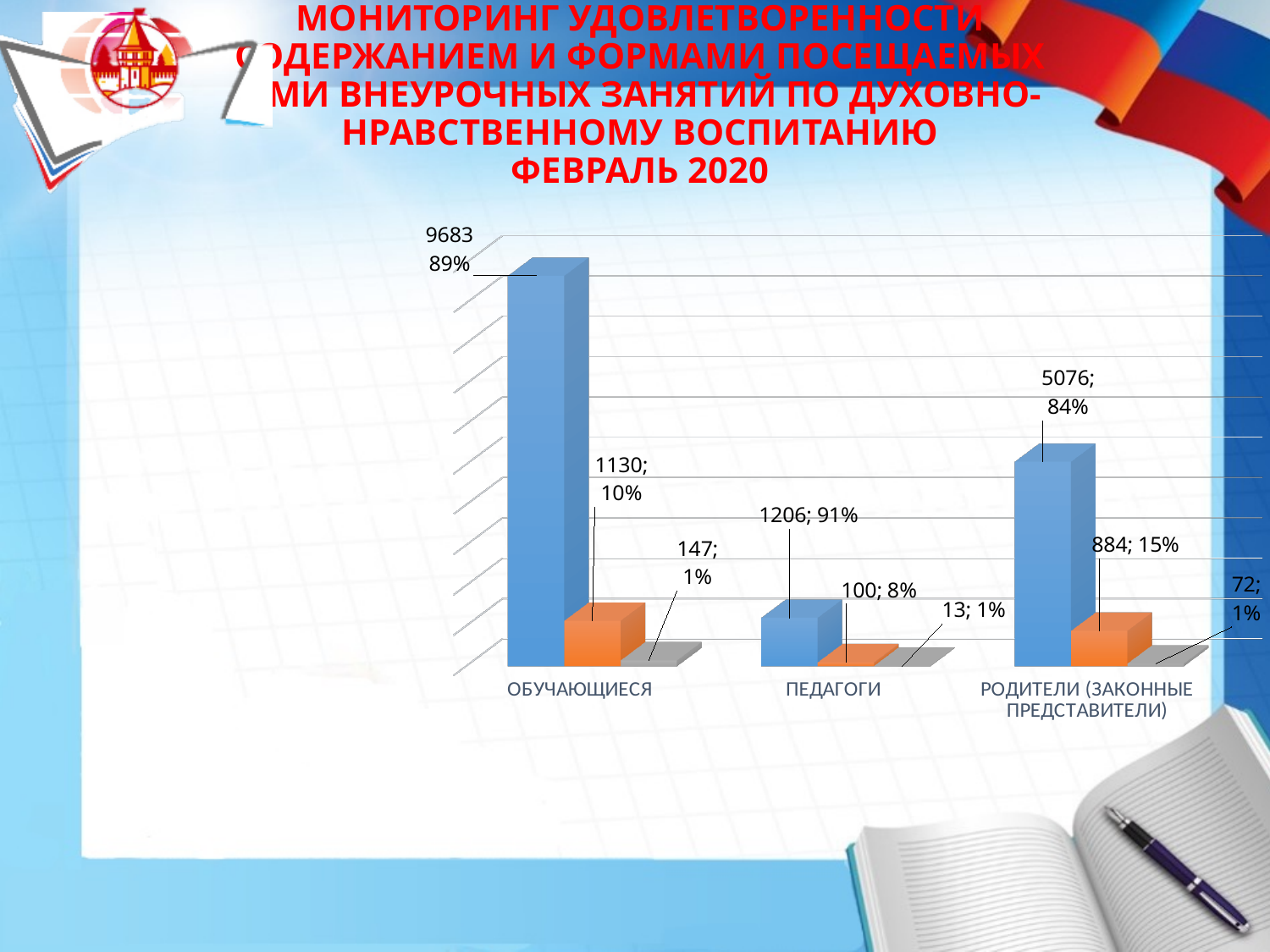
What is the value of the gray bar for РОДИТЕЛИ (ЗАКОННЫЕ ПРЕДСТАВИТЕЛИ)? 72; 1% What month and year are given in the chart title? ФЕВРАЛЬ 2020 Which category has the highest blue bar? ОБУЧАЮЩИЕСЯ What is the difference between the blue bar values for ОБУЧАЮЩИЕСЯ and РОДИТЕЛИ (ЗАКОННЫЕ ПРЕДСТАВИТЕЛИ)? 4607 How many categories are shown on the x axis of the chart? 3 What is the value of the orange bar for ПЕДАГОГИ? 100; 8% What is the value of the blue bar for РОДИТЕЛИ (ЗАКОННЫЕ ПРЕДСТАВИТЕЛИ)? 5076; 84% What is the value of the blue bar for ОБУЧАЮЩИЕСЯ? 9683; 89% Which category has the lowest gray bar? ПЕДАГОГИ Which is larger: the orange bar for ОБУЧАЮЩИЕСЯ or the orange bar for РОДИТЕЛИ (ЗАКОННЫЕ ПРЕДСТАВИТЕЛИ)? ОБУЧАЮЩИЕСЯ What is the total of the three bar values for ПЕДАГОГИ? 1319 What type of chart is shown on the slide? bar chart